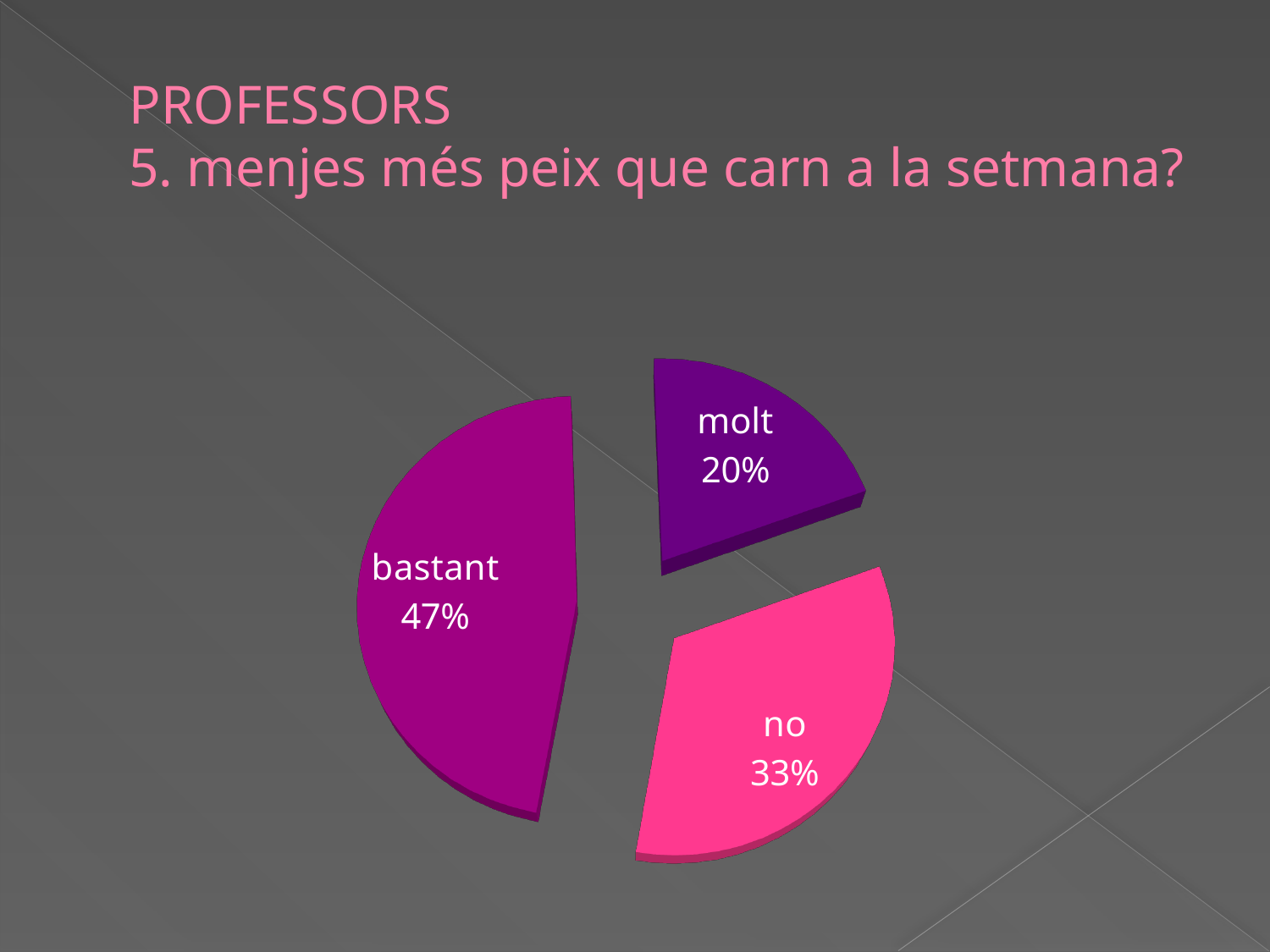
What question is the chart on the slide about? 5. menjes més peix que carn a la setmana? Which category has the largest slice of the pie? bastant Which category has the smallest slice of the pie? molt What share of the pie does the "bastant" slice represent? 47% What is the difference in percentage points between the "no" and "molt" slices? 13 What kind of chart is shown on the slide? pie chart What is the combined share of the "molt" and "bastant" slices? 67% What is the difference in percentage points between the "bastant" and "no" slices? 14 Which is larger, the "no" slice or the "molt" slice? no What share of the pie does the "no" slice represent? 33% How many slices does the pie chart have? 3 What share of the pie does the "molt" slice represent? 20%